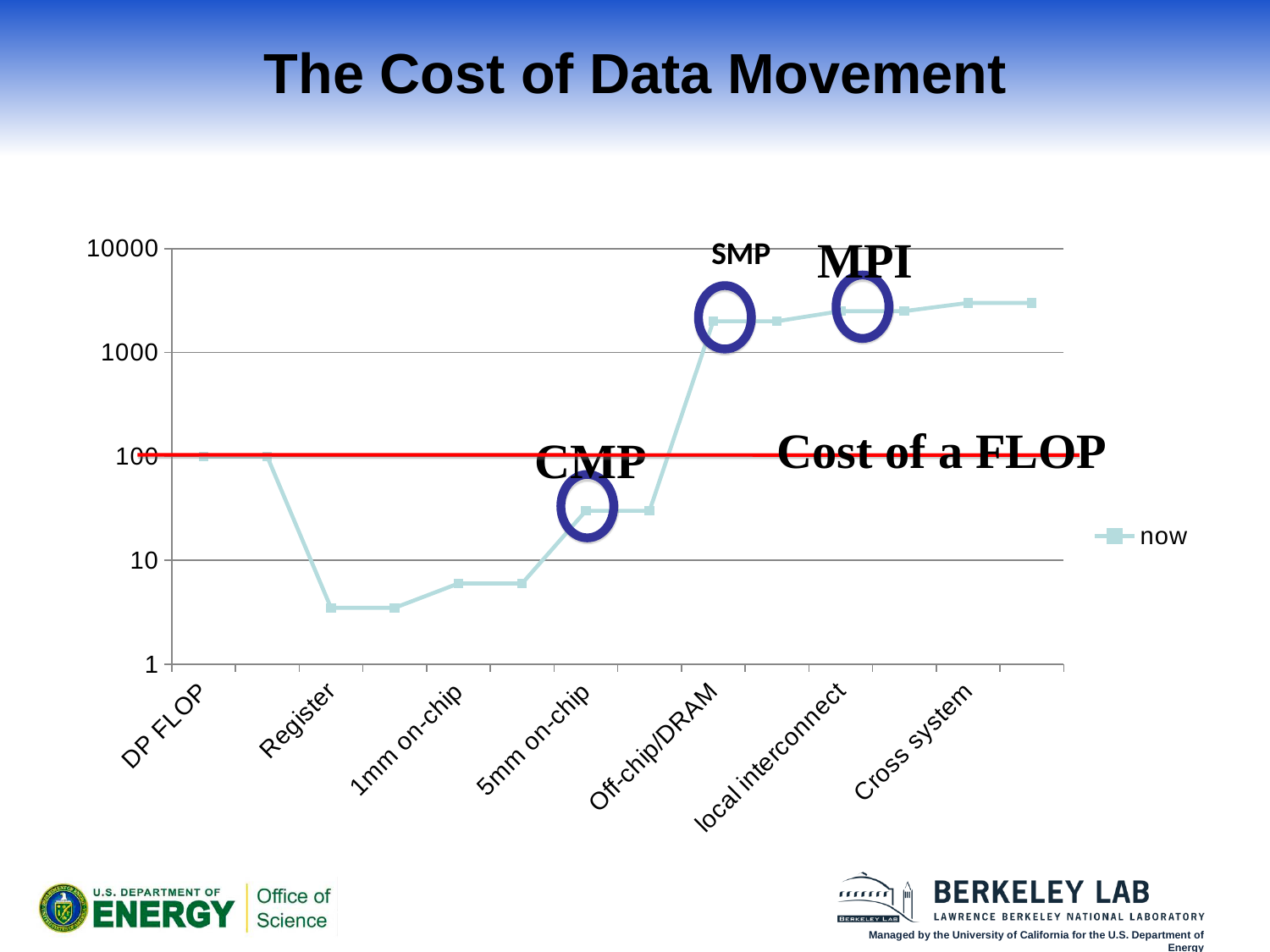
How many labeled categories are on the x axis? 7 How many series does the legend list? 1 What does the horizontal red line across the chart represent? Cost of a FLOP Is the value for 1mm on-chip greater or less than 10? less Is the value for Off-chip/DRAM greater or less than 1000? greater What is the name of the series in the legend? now Is the value for 5mm on-chip greater or less than 100? less Which labeled category has the highest value? Cross system Which labeled category has the lowest value? Register What kind of chart is shown on the slide? line chart Which has the larger value, Off-chip/DRAM or 5mm on-chip? Off-chip/DRAM